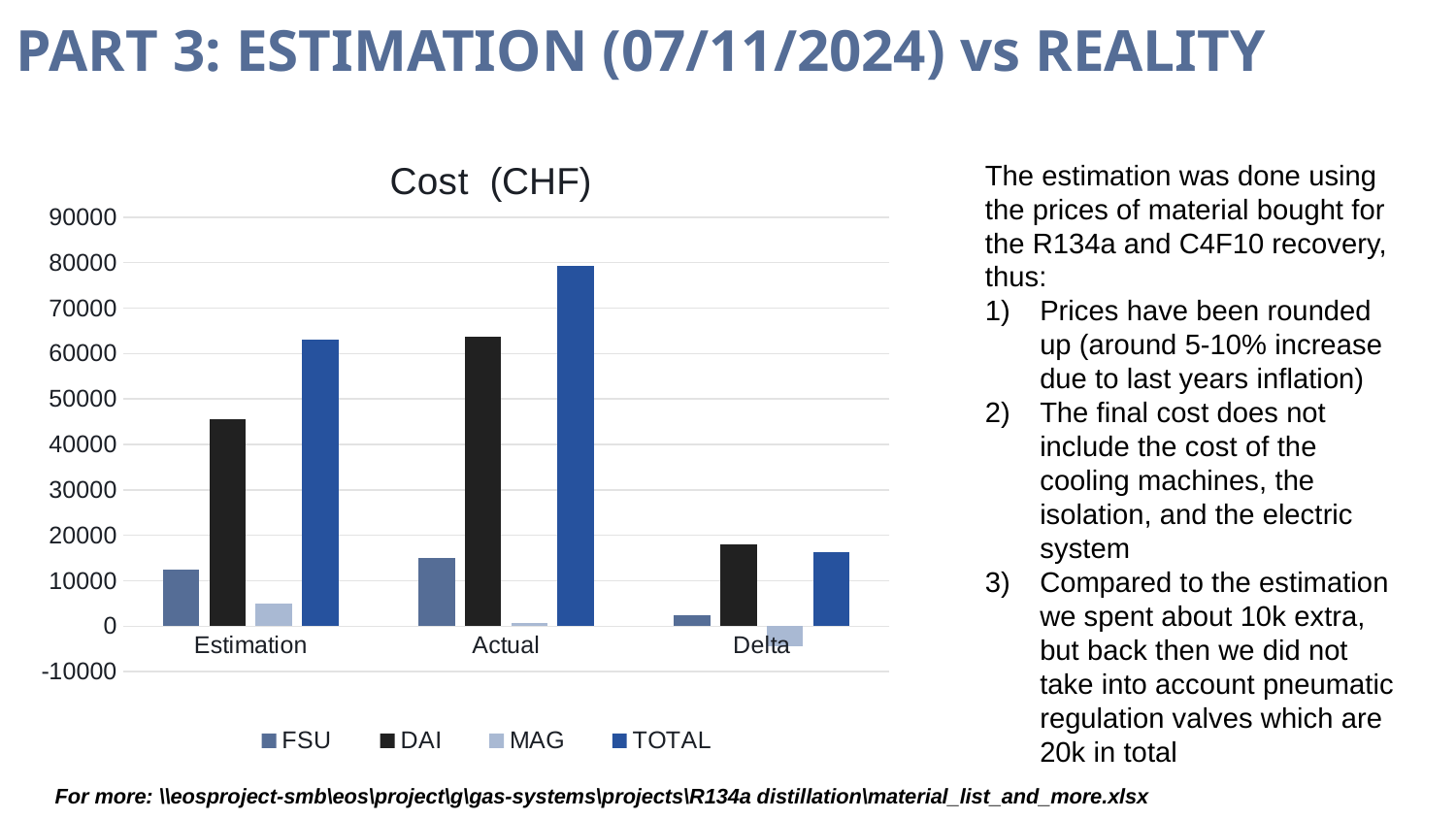
Which series has the highest value in the Estimation category? TOTAL What is the title of the chart? Cost (CHF) How many series does the legend of the chart list? 4 Which series has the lowest value in the Delta category? MAG Is the TOTAL value for Actual greater or less than 70000? greater Which is larger in the Estimation category, FSU or MAG? FSU Is the MAG value for Delta greater or less than 0? less Is the DAI value for Estimation greater or less than 50000? less Which series are listed in the chart's legend? FSU, DAI, MAG, TOTAL Which is larger, the DAI value for Actual or the DAI value for Estimation? Actual What kind of chart is shown on the slide? bar chart How many categories are shown on the x axis of the chart? 3